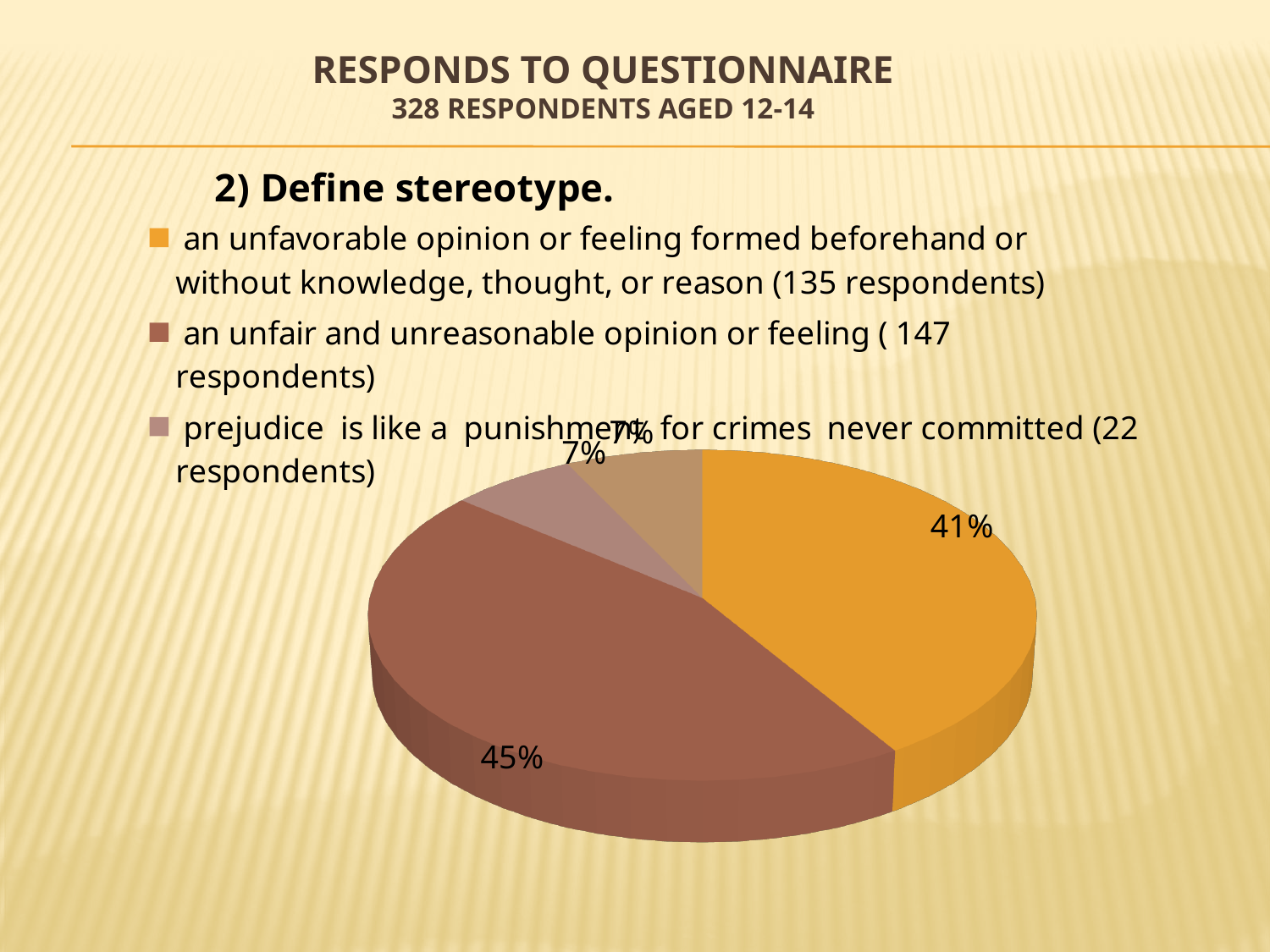
What share of the pie does the slice for "prejudice is like a punishment for crimes never committed" represent? 7% How many respondents chose "an unfair and unreasonable opinion or feeling"? 147 respondents What share of the pie does the slice for "an unfavorable opinion or feeling formed beforehand or without knowledge, thought, or reason" represent? 41% How many respondents chose "an unfavorable opinion or feeling formed beforehand or without knowledge, thought, or reason"? 135 respondents What share of the pie does the slice for "an unfair and unreasonable opinion or feeling" represent? 45% What kind of chart is shown on the slide? pie chart How many entries does the legend of the pie chart list? 3 What colour is the 41% slice of the pie chart? orange How many respondents chose "prejudice is like a punishment for crimes never committed"? 22 respondents What is the difference in percentage points between the 45% slice and the 41% slice? 4 percentage points Which is larger: the share for "an unfavorable opinion or feeling formed beforehand" or the share for "an unfair and unreasonable opinion or feeling"? an unfair and unreasonable opinion or feeling Which definition received the largest share of responses in the pie chart? an unfair and unreasonable opinion or feeling